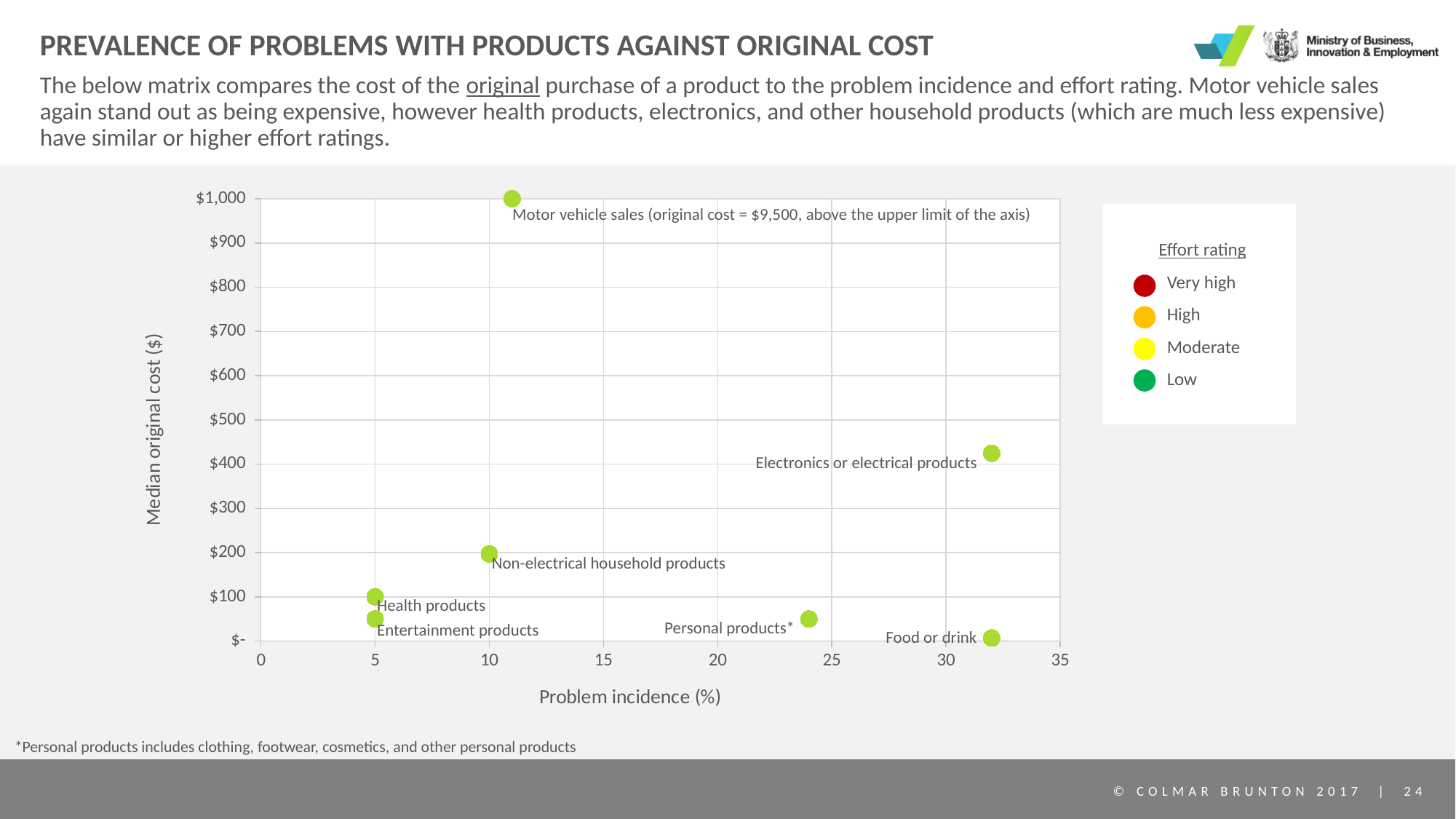
What is the original cost of Motor vehicle sales as noted on the chart? $9,500 Which product category has the highest median original cost? Motor vehicle sales What kind of chart is shown on the slide? Scatter chart Is the problem incidence for Food or drink greater or less than 30%? greater How many effort rating levels does the legend list? 4 Which product category has the lowest median original cost? Food or drink What is the title of the x axis? Problem incidence (%) How many product categories are plotted on the chart? 7 Which has a higher median original cost, Electronics or electrical products or Non-electrical household products? Electronics or electrical products Is the median original cost for Electronics or electrical products greater or less than $400? greater Which has a higher problem incidence, Personal products or Health products? Personal products Is the median original cost for Personal products greater or less than $100? less